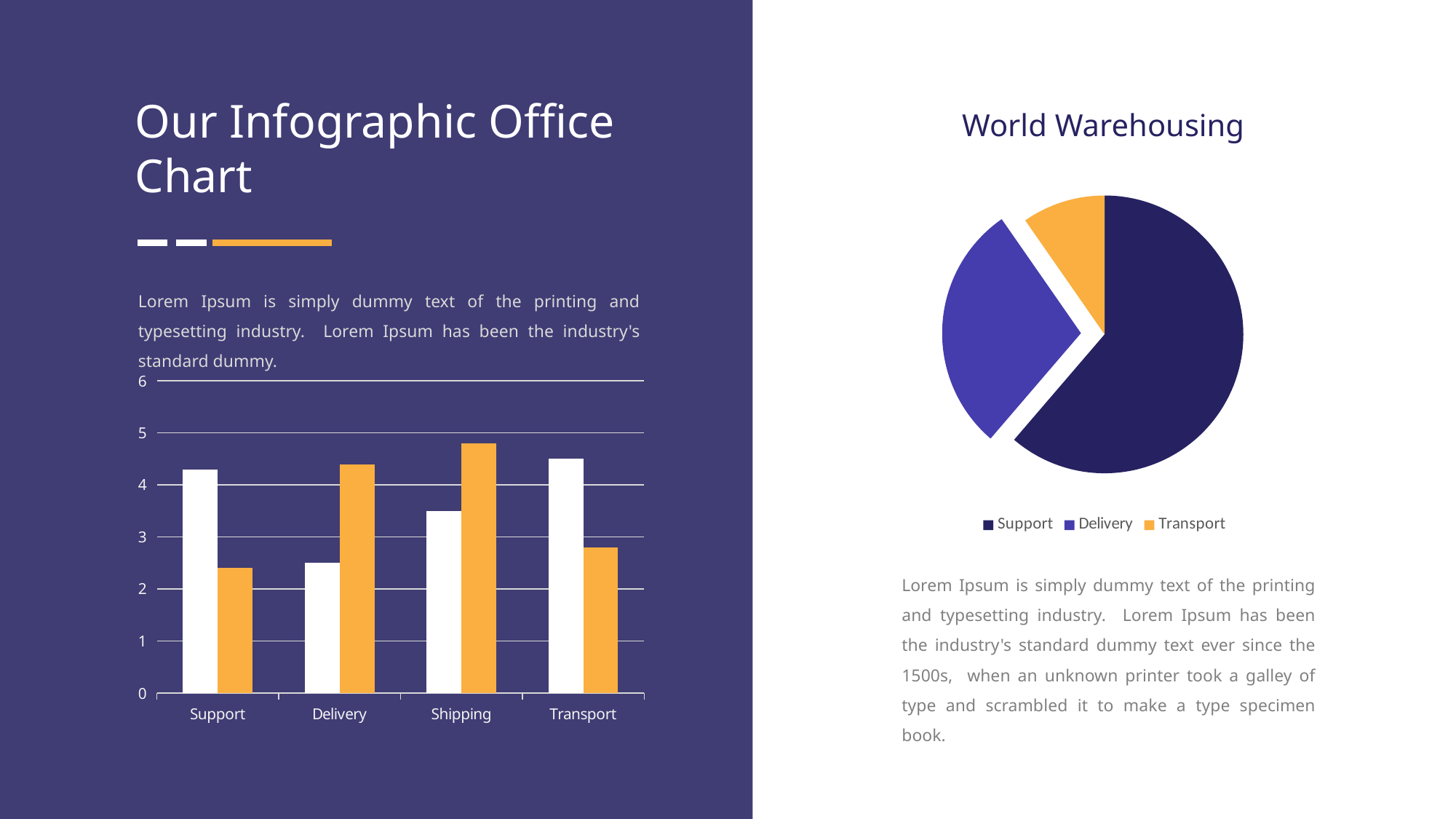
In the bar chart on the left, is the white bar for Delivery greater or less than 3? less In the bar chart on the left, how many categories are shown on the x axis? 4 In the bar chart on the left, is the orange bar for Support greater or less than 3? less In the 'World Warehousing' pie chart, how many categories does the legend list? 3 In the bar chart on the left, which is larger for Transport, the white bar or the orange bar? the white bar In the bar chart on the left, is the orange bar for Shipping greater or less than 4? greater In the bar chart on the left, which category has the highest orange bar? Shipping What kind of chart is shown on the left side of the slide? bar chart In the 'World Warehousing' pie chart, which category has the largest slice? Support What kind of chart is the 'World Warehousing' chart? pie chart In the bar chart on the left, which is larger for Delivery, the white bar or the orange bar? the orange bar